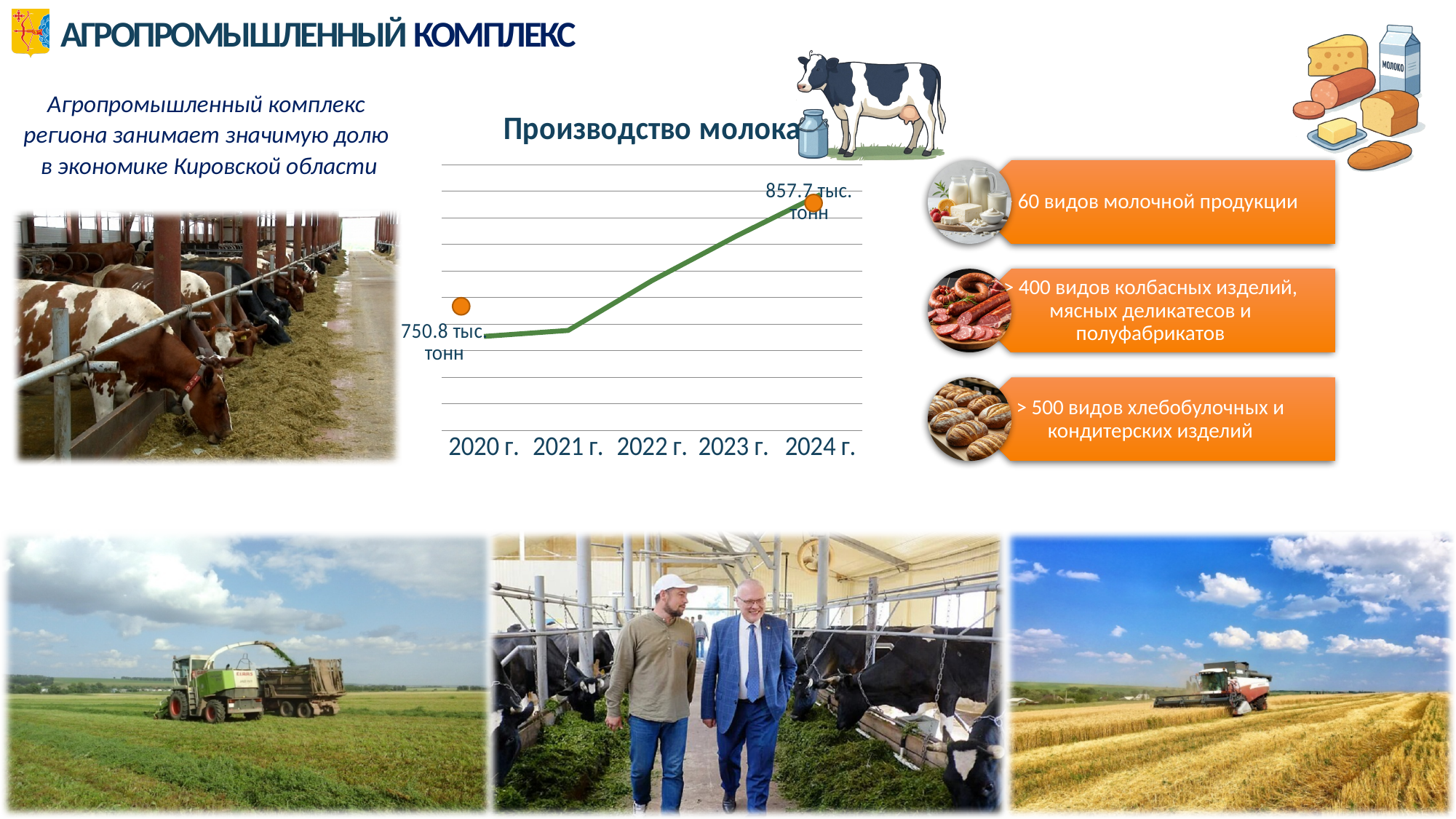
What is the milk production value shown for 2020 г.? 750.8 тыс. тонн Which year has the larger milk production value, 2020 г. or 2024 г.? 2024 г. Which year has the highest milk production on the chart? 2024 г. What is the milk production value shown for 2024 г.? 857.7 тыс. тонн Which year has the lowest milk production on the chart? 2020 г. What is the first year shown on the x axis of the chart? 2020 г. Does milk production rise or fall from 2020 г. to 2024 г.? rise What is the title of the chart? Производство молока How many years are shown on the x axis of the chart? 5 Which year has the larger milk production value, 2021 г. or 2023 г.? 2023 г. What type of chart is used to show milk production? line chart By how much did milk production increase from 2020 г. to 2024 г.? 106.9 тыс. тонн